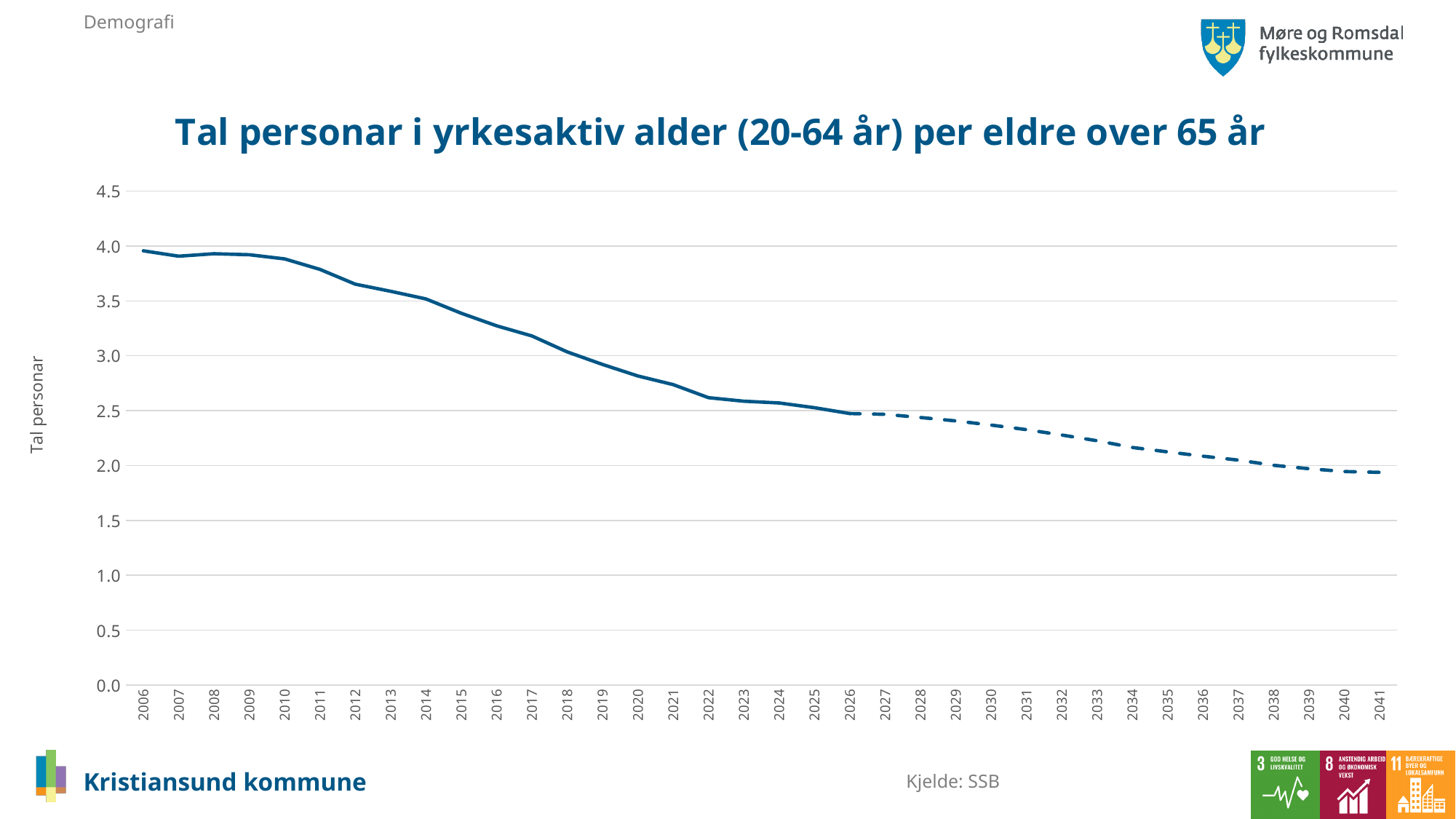
Is the value for 2041 greater or less than 2.0? less Is the value for 2006 greater or less than 3.5? greater Which year has the larger value, 2010 or 2025? 2010 Is the value for 2017 greater or less than 3.0? greater Which year has the highest value on the chart? 2006 How many years are shown on the x axis of the chart? 36 Do the values rise or fall along the x axis from 2006 to 2041? fall Which year has the lowest value on the chart? 2041 What is the title of the chart? Tal personar i yrkesaktiv alder (20-64 år) per eldre over 65 år What is the label on the vertical axis of the chart? Tal personar What kind of chart is shown on the slide? line chart